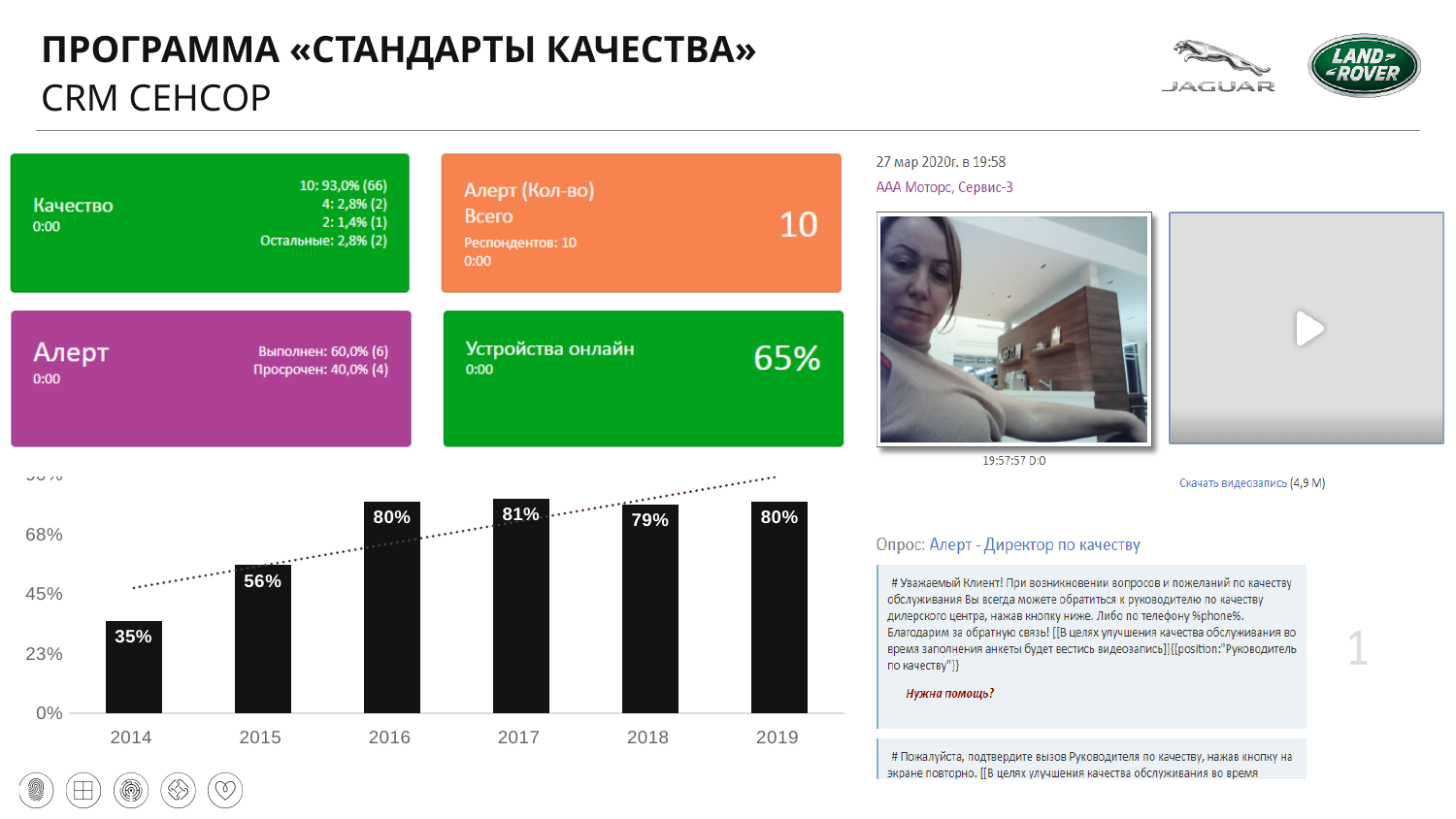
How many years are shown on the x axis of the bar chart? 6 What is the value for 2019 in the bar chart? 80% Which year has the highest value in the bar chart? 2017 What kind of chart is shown at the bottom left of the slide? Bar chart Which is larger in the bar chart, the value for 2016 or the value for 2015? 2016 What is the value for 2014 in the bar chart? 35% What is the difference between the values for 2016 and 2015 in the bar chart? 24% What is the value for 2018 in the bar chart? 79% What is the difference between the values for 2015 and 2014 in the bar chart? 21% Do the values in the bar chart generally rise or fall from 2014 to 2019? Rise What is the value for 2015 in the bar chart? 56% Which year has the lowest value in the bar chart? 2014